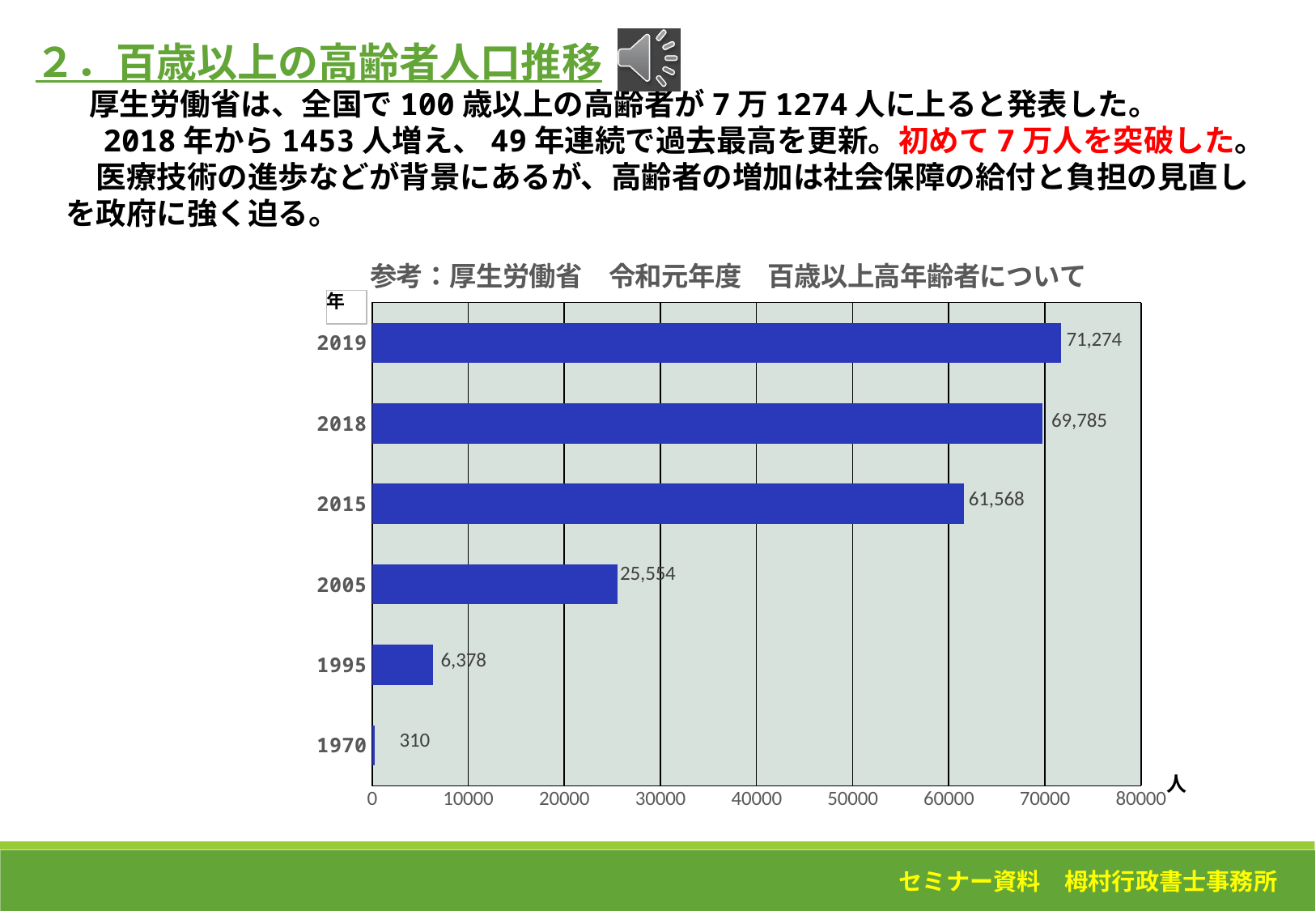
How many years are shown on the chart? 6 What kind of chart is this? bar chart What is the difference between the values for 2019 and 2018? 1,489 Which year has the highest value? 2019 What is the value for 1970? 310 What is the value for 2019? 71,274 What is the title of the chart? 参考：厚生労働省 令和元年度 百歳以上高年齢者について What is the difference between the values for 2015 and 2005? 36,014 Is the value for 2015 greater or less than 60000? greater Which is larger, the value for 1995 or the value for 2005? 2005 What is the value for 2005? 25,554 Which year has the lowest value? 1970